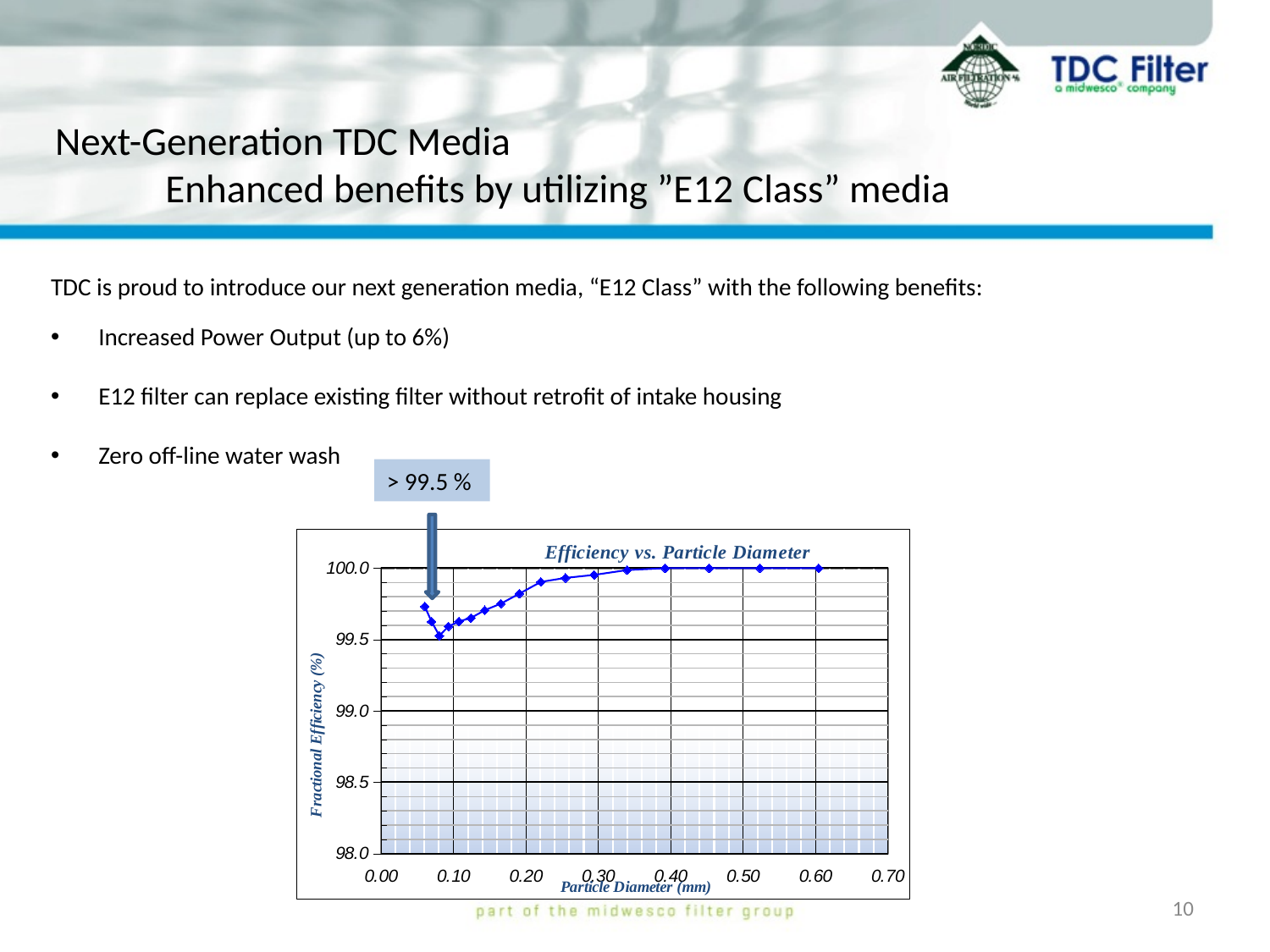
Do the efficiency values rise or fall as particle diameter increases from 0.10 mm to 0.40 mm? rise What is the highest value shown on the y axis of the chart? 100.0 Is the lowest efficiency value plotted on the chart greater or less than 99.0? greater Is the efficiency value at a particle diameter of 0.60 mm greater or less than 99.5? greater What kind of chart is shown on the slide? line chart Is the efficiency value at 0.50 mm larger or smaller than the efficiency value at 0.10 mm? larger Is the efficiency value at a particle diameter of 0.40 mm greater or less than 99.5? greater What is the title of the chart? Efficiency vs. Particle Diameter What is the label of the y axis of the chart? Fractional Efficiency (%)